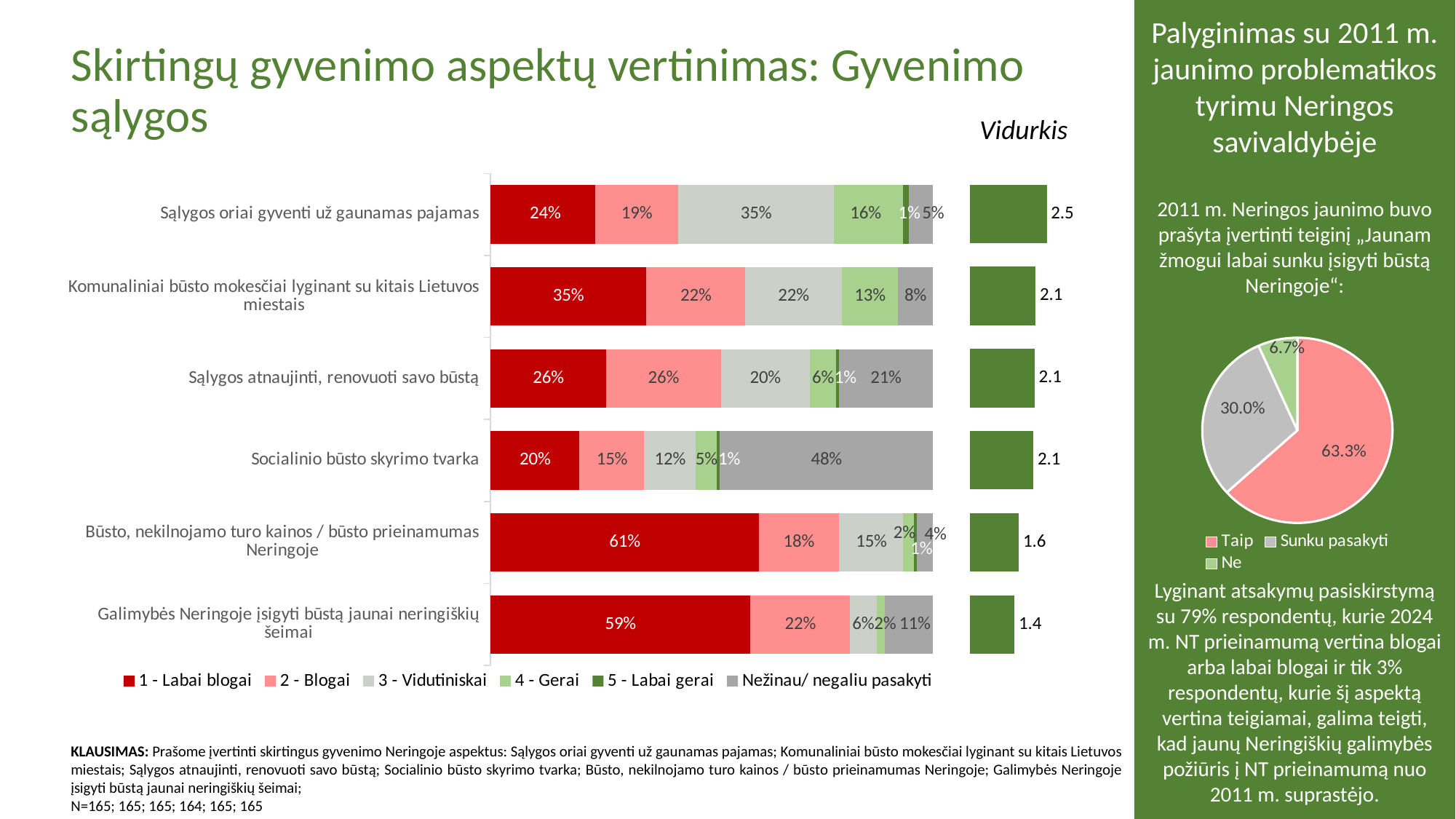
In the main stacked bar chart, what percentage of respondents rated 'Būsto, nekilnojamo turo kainos / būsto prieinamumas Neringoje' as '1 - Labai blogai'? 61% In the pie chart on the right, which answer has the smallest slice? Ne How many categories are shown in the main stacked bar chart? 6 In the 'Vidurkis' chart, what is the average value for 'Galimybės Neringoje įsigyti būstą jaunai neringiškių šeimai'? 1.4 In the main stacked bar chart, what is the difference between the '1 - Labai blogai' shares for 'Komunaliniai būsto mokesčiai lyginant su kitais Lietuvos miestais' and 'Socialinio būsto skyrimo tvarka'? 15% In the main stacked bar chart, what is the '3 - Vidutiniskai' share for 'Sąlygos oriai gyventi už gaunamas pajamas'? 35% How many series does the legend of the main stacked bar chart list? 6 In the main stacked bar chart, what is the 'Nežinau/ negaliu pasakyti' share for 'Socialinio būsto skyrimo tvarka'? 48% In the 'Vidurkis' chart, which category has the highest average? Sąlygos oriai gyventi už gaunamas pajamas In the pie chart on the right, what share of respondents answered 'Taip'? 63.3% What type of chart is the main chart on the left of the slide? Stacked bar chart In the main stacked bar chart, which category has the highest '1 - Labai blogai' share? Būsto, nekilnojamo turo kainos / būsto prieinamumas Neringoje